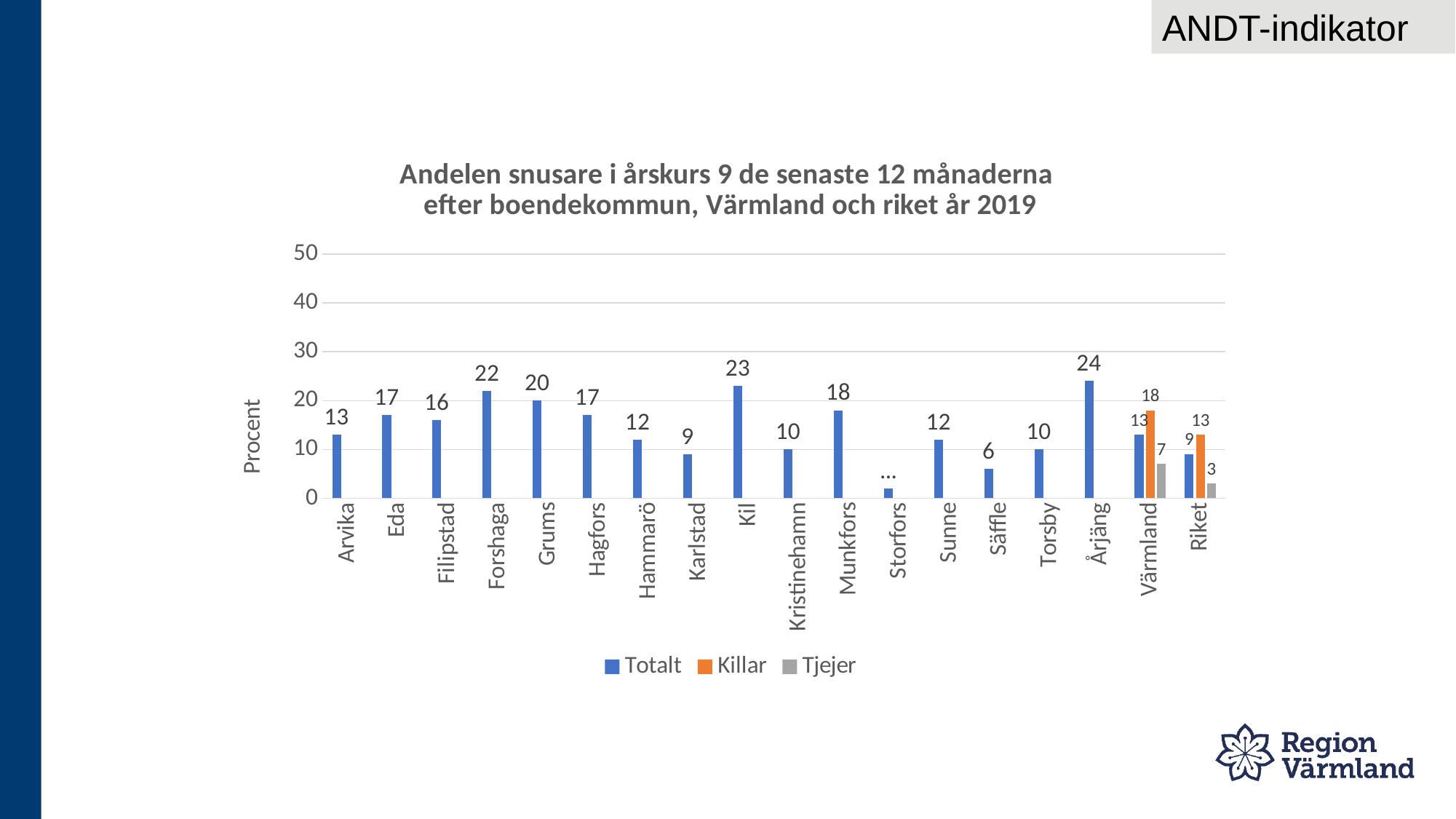
How many categories are shown on the x axis? 18 Is the Totalt value for Årjäng greater or less than 20? greater What is the difference between the Totalt values for Forshaga and Arvika? 9 What is the difference between the Killar and Tjejer values for Värmland? 11 What is the Killar value for Värmland? 18 What kind of chart is shown on the slide? bar chart What is the label of the y axis? Procent Which municipality has the highest Totalt value? Årjäng What is the Totalt value for Kil? 23 What is the Tjejer value for Riket? 3 Which has a higher Totalt value, Grums or Munkfors? Grums How many series does the legend list? 3